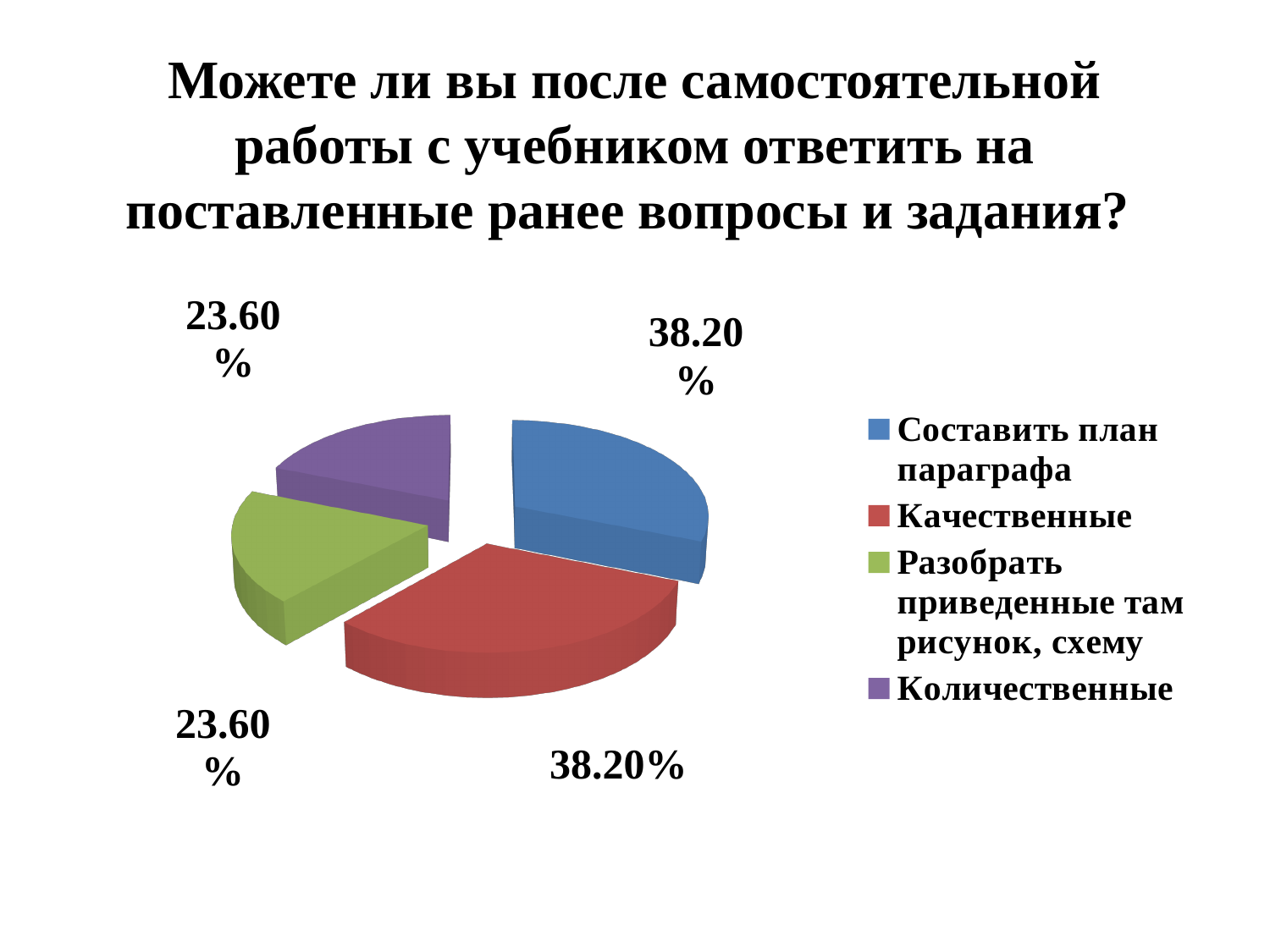
How many entries does the legend list? 4 What is the value for "Составить план параграфа"? 38.20% Which is larger, the value for "Составить план параграфа" or the value for "Количественные"? Составить план параграфа Which legend entry is shown in purple? Количественные What kind of chart is shown on the slide? pie chart What is the value for "Количественные"? 23.60% What is the value for "Качественные"? 38.20% What is the value for "Разобрать приведенные там рисунок, схему"? 23.60% How many slices does the pie chart have? 4 Which is larger, the value for "Разобрать приведенные там рисунок, схему" or the value for "Качественные"? Качественные What colour is the slice for "Качественные"? red What is the difference between the value for "Качественные" and the value for "Количественные"? 14.60%